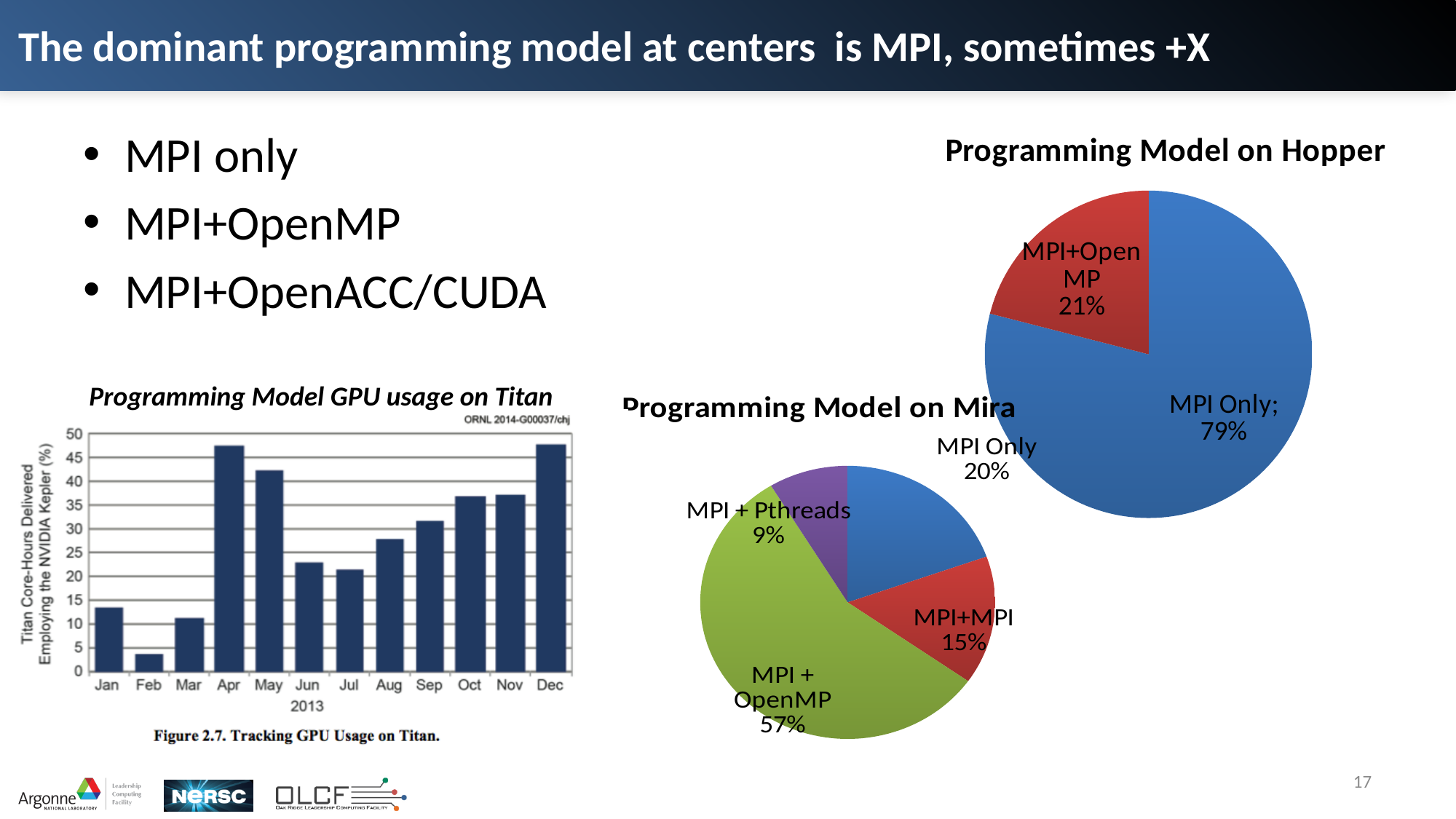
In the Programming Model on Mira pie chart, what share is MPI + Pthreads? 9% In the Programming Model on Mira pie chart, what is the difference in percentage points between MPI Only and MPI+MPI? 5 In the Programming Model GPU usage on Titan chart, is the value for Apr greater or less than 45? greater In the Programming Model on Mira pie chart, what share is MPI + OpenMP? 57% In the Programming Model on Hopper pie chart, what share is MPI Only? 79% What kind of chart is the Programming Model GPU usage on Titan chart? bar chart In the Programming Model GPU usage on Titan chart, how many months are shown on the x axis? 12 In the Programming Model on Mira pie chart, which programming model has the largest share? MPI + OpenMP In the Programming Model on Mira pie chart, which programming model has the smallest share? MPI + Pthreads In the Programming Model on Mira pie chart, how many slices are there? 4 In the Programming Model GPU usage on Titan chart, which month has the lowest value? Feb In the Programming Model on Hopper pie chart, what share is MPI+OpenMP? 21%